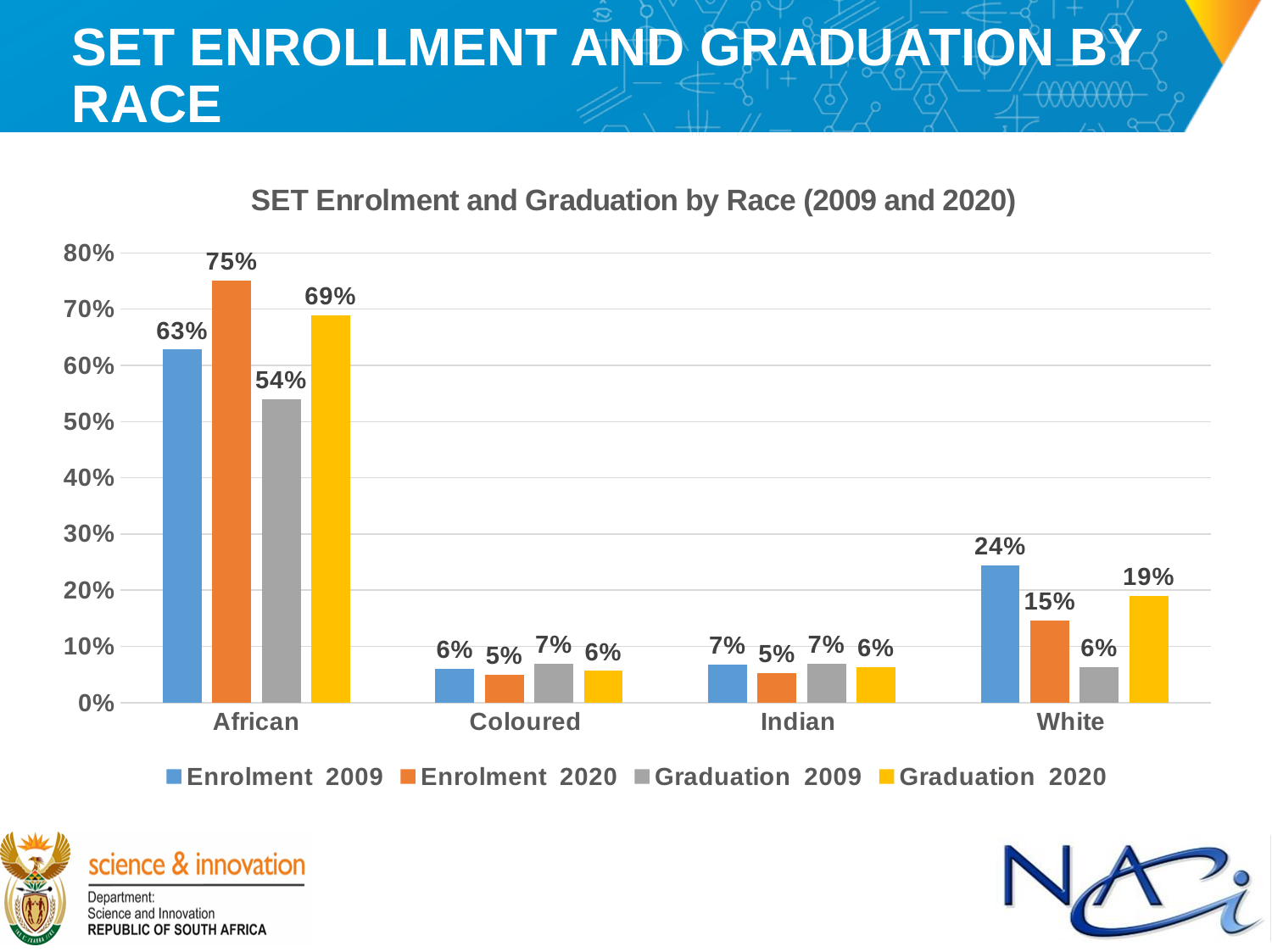
How many series does the legend list? 4 Which race category has the lowest Enrolment 2020 value? Coloured and Indian (both 5%) What is the Enrolment 2020 value for African? 75% What is the Enrolment 2009 value for Indian? 7% Which is larger for White: Enrolment 2009 or Graduation 2020? Enrolment 2009 What is the Graduation 2009 value for White? 6% How many race categories are shown on the x axis? 4 Which race category has the highest Graduation 2020 value? African What is the difference between Graduation 2020 and Graduation 2009 for African? 15% What is the title of the chart? SET Enrolment and Graduation by Race (2009 and 2020) What kind of chart is shown on the slide? Bar chart What is the difference between Enrolment 2009 and Enrolment 2020 for White? 9%